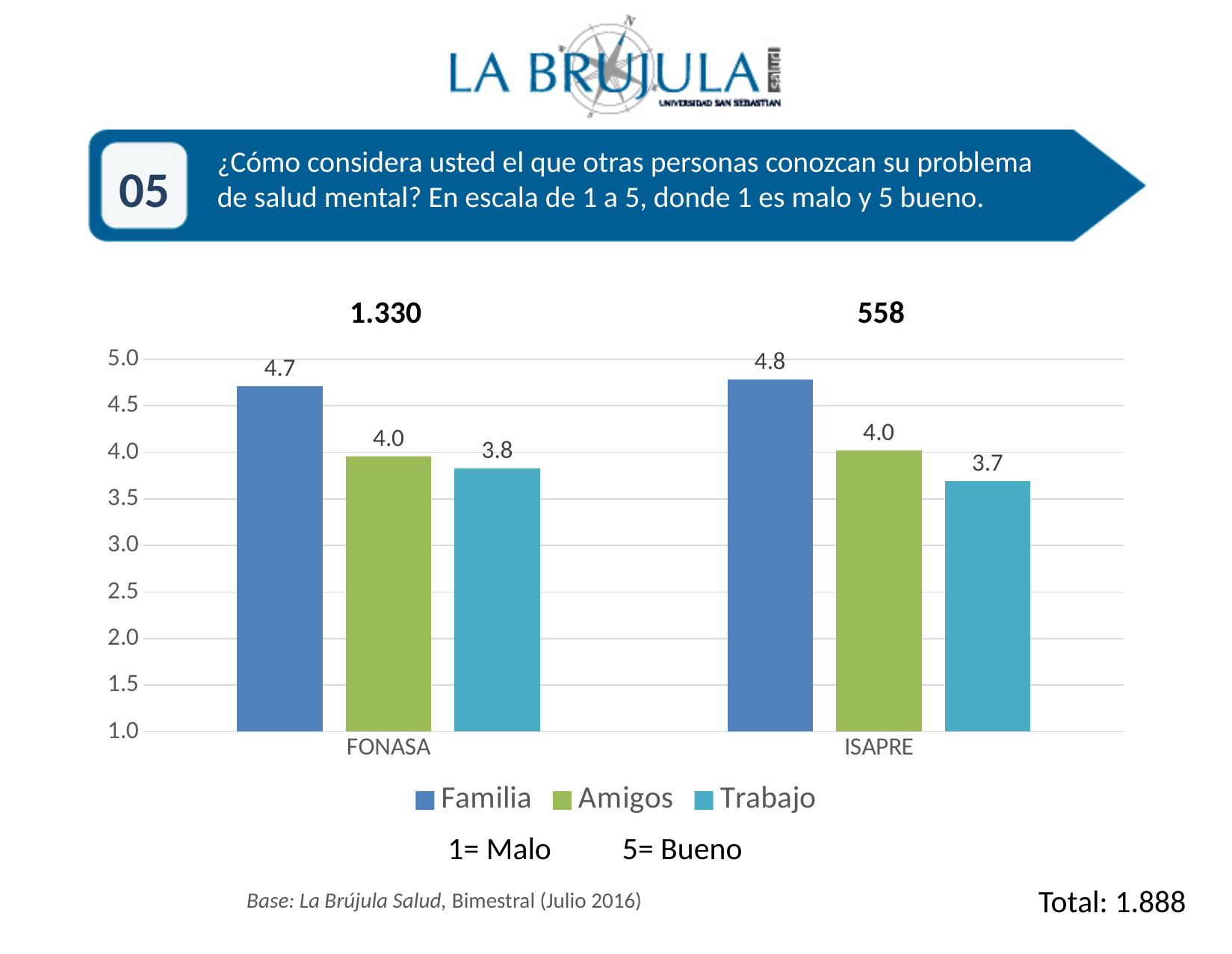
Which is larger, the Familia value for FONASA or the Familia value for ISAPRE? ISAPRE Which series has the lowest value in the FONASA group? Trabajo How many series does the legend list? 3 Which series has the highest value in the ISAPRE group? Familia What kind of chart is shown on the slide? bar chart How many categories are shown on the x axis? 2 What number is printed above the ISAPRE group of bars? 558 What is the value for Amigos in the ISAPRE group? 4.0 What is the difference between the Familia and Trabajo values in the FONASA group? 0.9 What is the value for Trabajo in the ISAPRE group? 3.7 Is the value for Trabajo in the ISAPRE group greater or less than 4.0? less What is the value for Familia in the FONASA group? 4.7